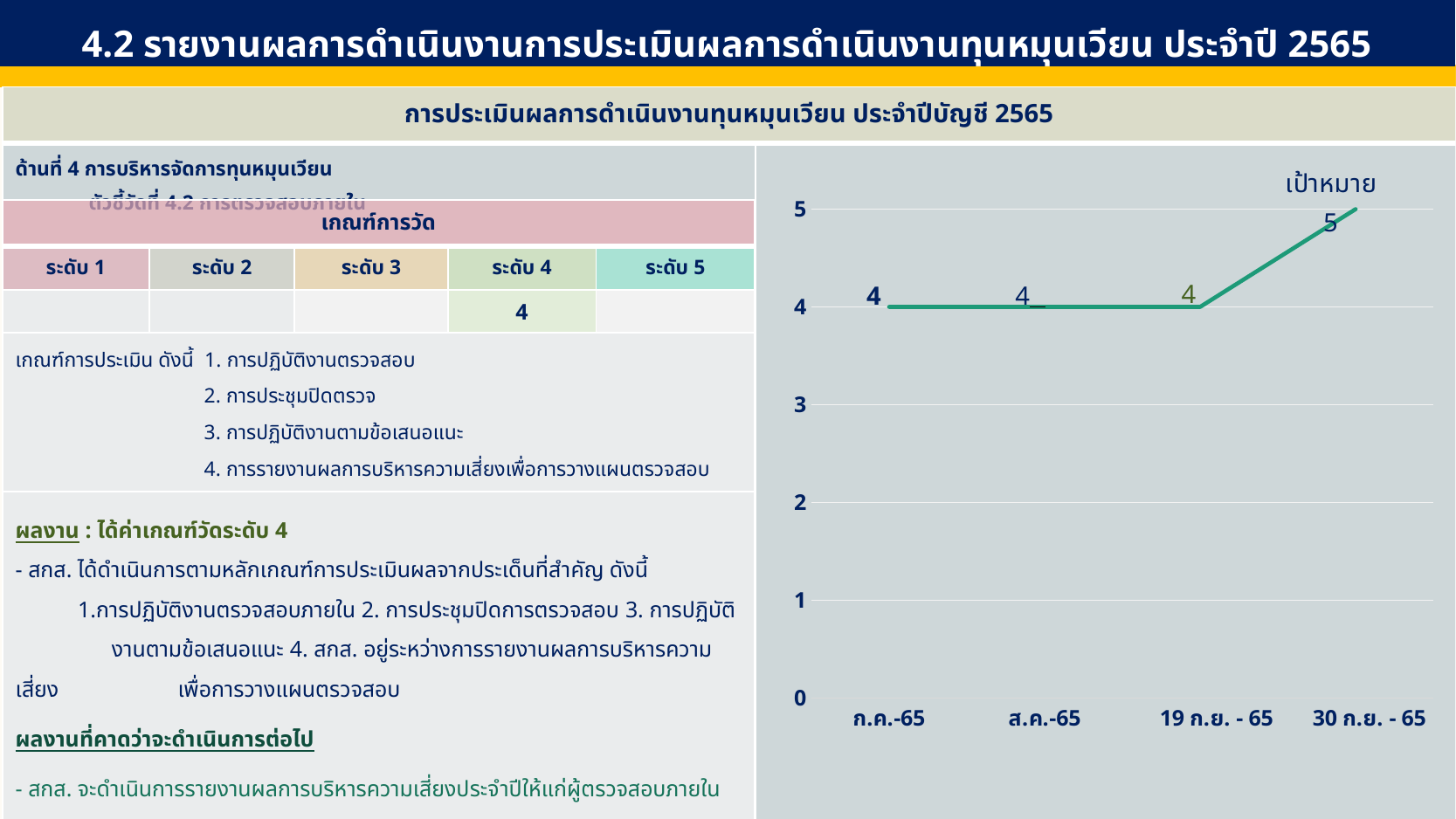
What label is written above the last point of the line chart? เป้าหมาย What is the value for ก.ค.-65 in the line chart? 4 What is the value for 19 ก.ย. - 65 in the line chart? 4 What type of chart is shown on the right side of the slide? line chart What is the value for ส.ค.-65 in the line chart? 4 Which is larger in the line chart, the value for ก.ค.-65 or the value for 30 ก.ย. - 65? 30 ก.ย. - 65 Which category has the highest value in the line chart? 30 ก.ย. - 65 What is the value for 30 ก.ย. - 65 in the line chart? 5 Is the value for ส.ค.-65 in the line chart greater or less than 3? greater What is the difference between the values for 30 ก.ย. - 65 and 19 ก.ย. - 65 in the line chart? 1 How many categories are shown on the x axis of the line chart? 4 Do the values in the line chart rise or fall from 19 ก.ย. - 65 to 30 ก.ย. - 65? rise